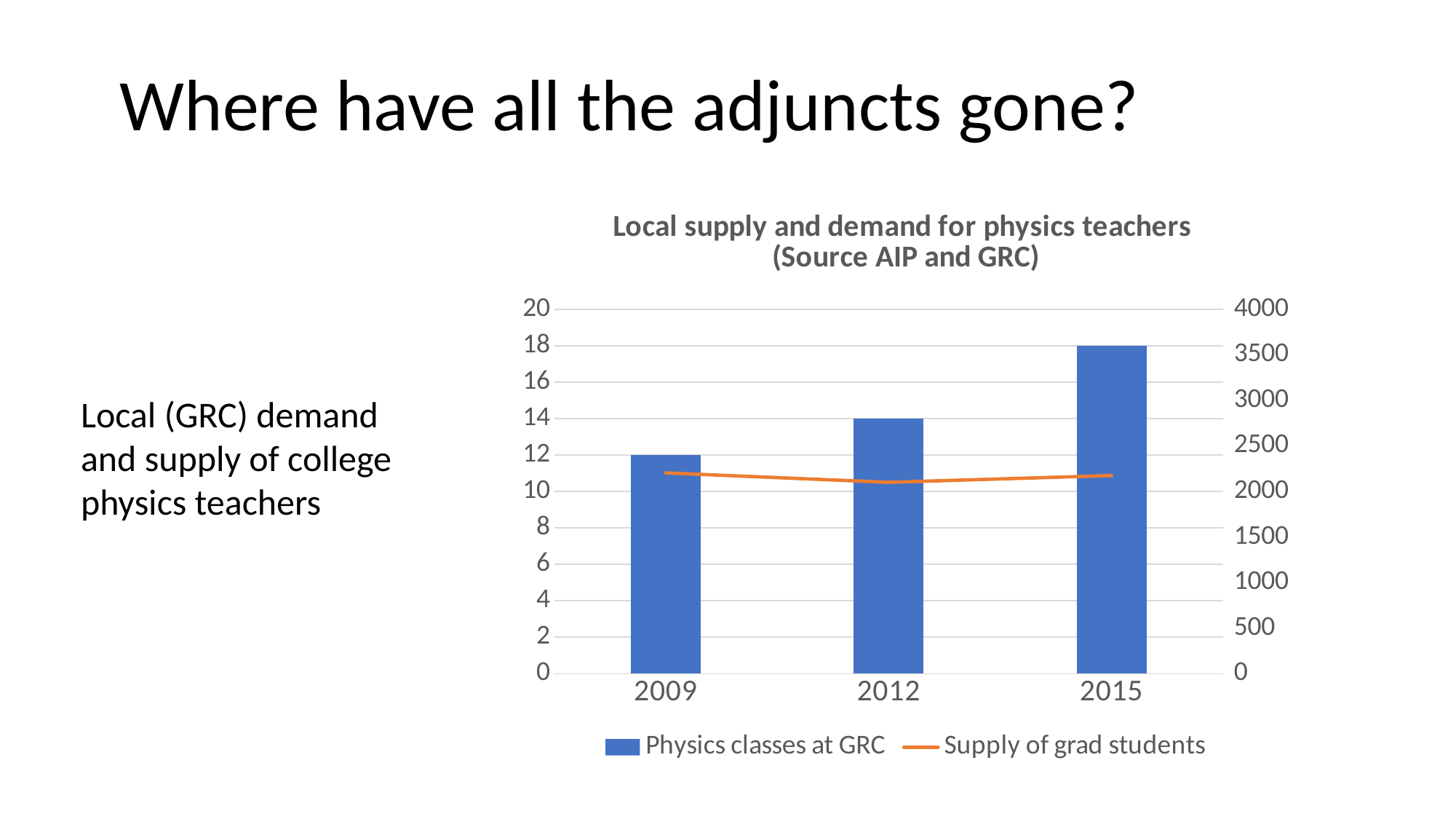
What is the value for Physics classes at GRC in 2015? 18 Which year has the lowest number of Physics classes at GRC? 2009 Is the value for Supply of grad students in 2015 greater or less than 2500? less How many series does the chart legend list? 2 What is the value for Physics classes at GRC in 2012? 14 Is the value for Supply of grad students in 2009 greater or less than 2000? greater What is the value for Physics classes at GRC in 2009? 12 How many years are shown on the x axis of the chart? 3 Which year has the highest number of Physics classes at GRC? 2015 Which year has more Physics classes at GRC, 2012 or 2015? 2015 What is the difference in Physics classes at GRC between 2015 and 2009? 6 Do the Physics classes at GRC values rise or fall from 2009 to 2015? rise